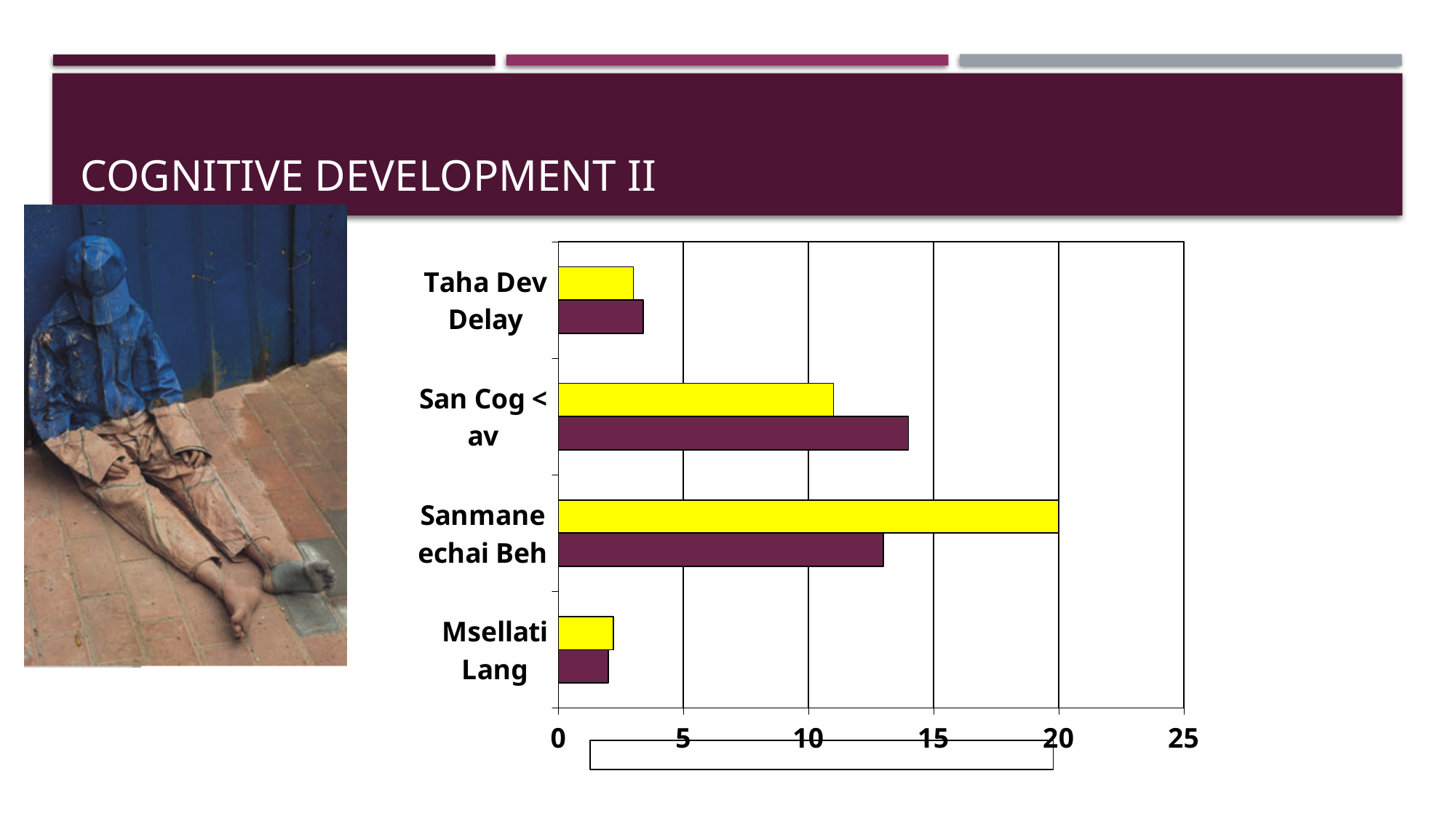
For San Cog < av, which bar is longer, the yellow or the maroon one? maroon What is the highest value shown on the horizontal axis? 25 Is the maroon bar for Taha Dev Delay greater or less than 5? less Which category has the longest maroon bar? San Cog < av Which category has the longest yellow bar? Sanmane echai Beh What is the value of the yellow bar for Sanmane echai Beh? 20 How many categories are shown on the chart? 4 What kind of chart is shown on the slide? bar chart For Sanmane echai Beh, which bar is longer, the yellow or the maroon one? yellow Is the maroon bar for Sanmane echai Beh greater or less than 10? greater Is the yellow bar for San Cog < av greater or less than 10? greater Which category has the shortest maroon bar? Msellati Lang